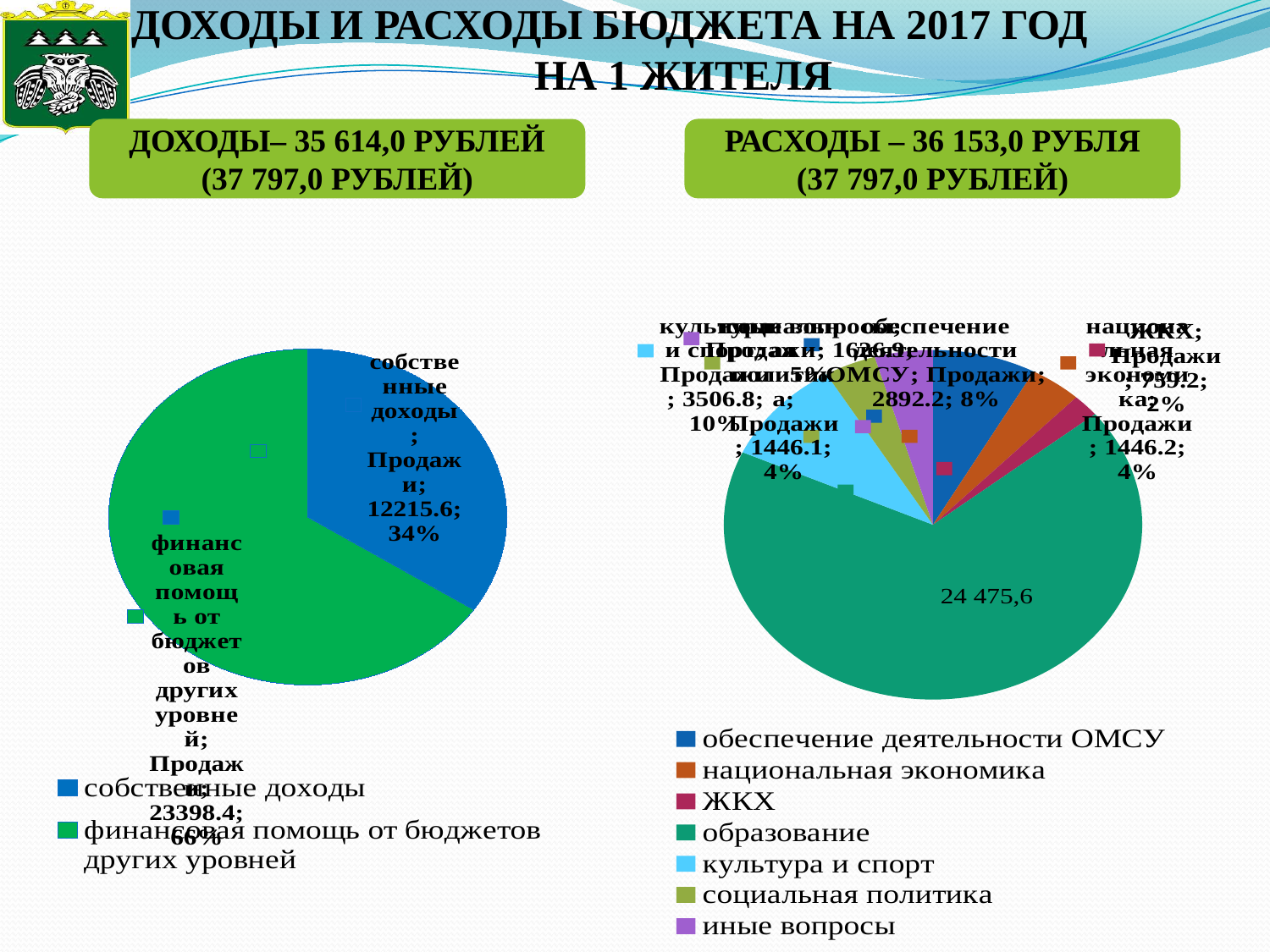
In the left chart (ДОХОДЫ), which is larger: собственные доходы or финансовая помощь от бюджетов других уровней? финансовая помощь от бюджетов других уровней In the right chart (РАСХОДЫ), what is the value for образование? 24 475,6 What kind of chart is the left chart (ДОХОДЫ)? pie chart How many slices does the left chart (ДОХОДЫ) have? 2 In the right chart (РАСХОДЫ), what share of the pie is обеспечение деятельности ОМСУ? 8% In the right chart (РАСХОДЫ), which category has the smallest slice? ЖКХ In the left chart (ДОХОДЫ), what is the value for собственные доходы? 12215.6 In the left chart (ДОХОДЫ), what is the difference between финансовая помощь от бюджетов других уровней (23398.4) and собственные доходы (12215.6)? 11182.8 In the right chart (РАСХОДЫ), what is the value for национальная экономика? 1446.2 How many entries does the legend of the right chart (РАСХОДЫ) list? 7 In the right chart (РАСХОДЫ), which category has the largest slice? образование In the left chart (ДОХОДЫ), what share of the pie is финансовая помощь от бюджетов других уровней? 66%